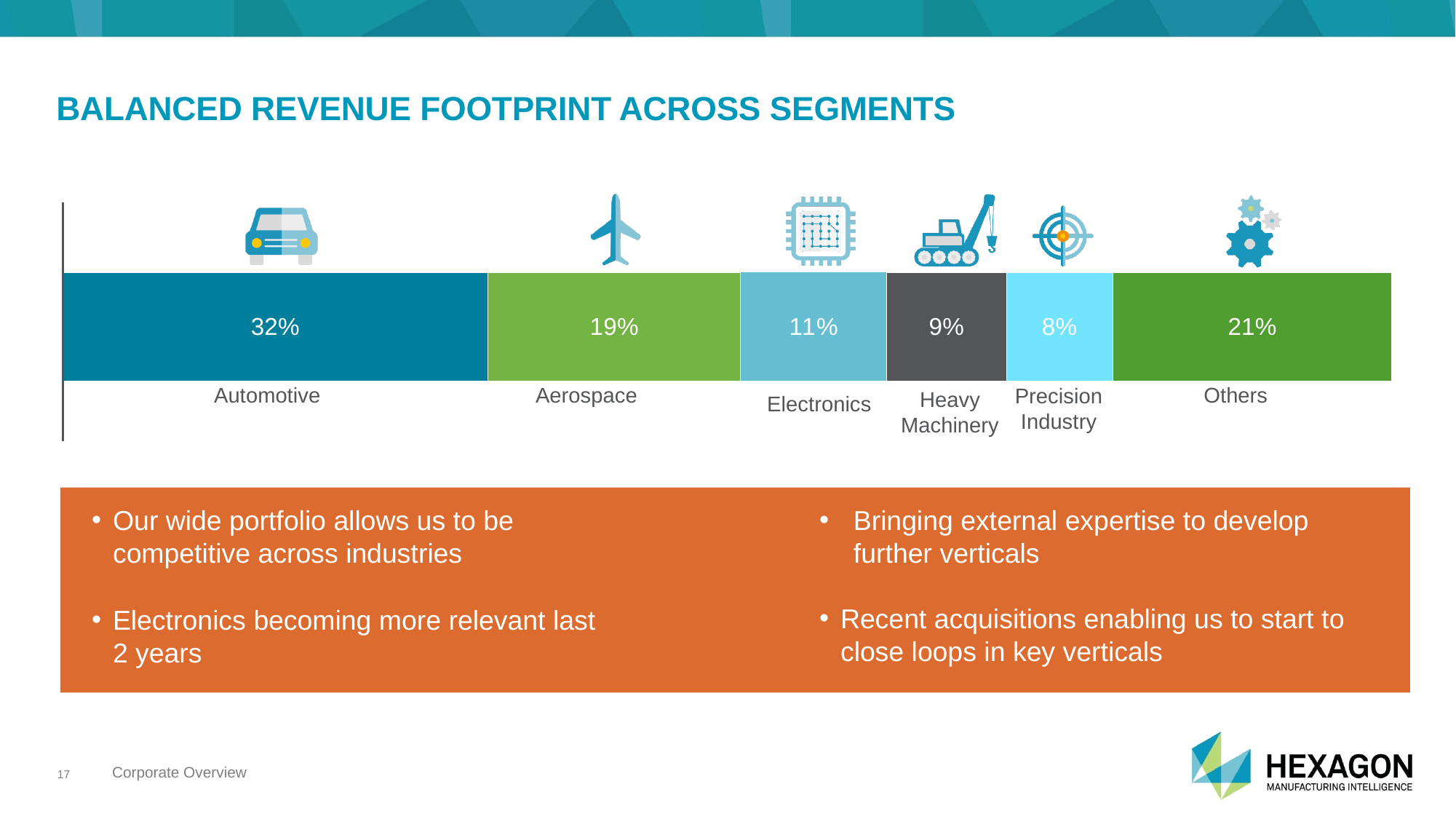
How many segments are shown in the chart? 6 What share of revenue comes from the Aerospace segment? 19% Which segment has a larger share, Others or Aerospace? Others What is the difference in percentage points between the Automotive and Aerospace shares? 13 What share of revenue comes from the Precision Industry segment? 8% What is the combined share of Electronics and Heavy Machinery? 20% What share of revenue comes from the Automotive segment? 32% What share of revenue comes from the Electronics segment? 11% Which segment has the largest share of revenue? Automotive What share of revenue comes from the Heavy Machinery segment? 9% What is the title of the slide containing the chart? BALANCED REVENUE FOOTPRINT ACROSS SEGMENTS Which segment has the smallest share of revenue? Precision Industry